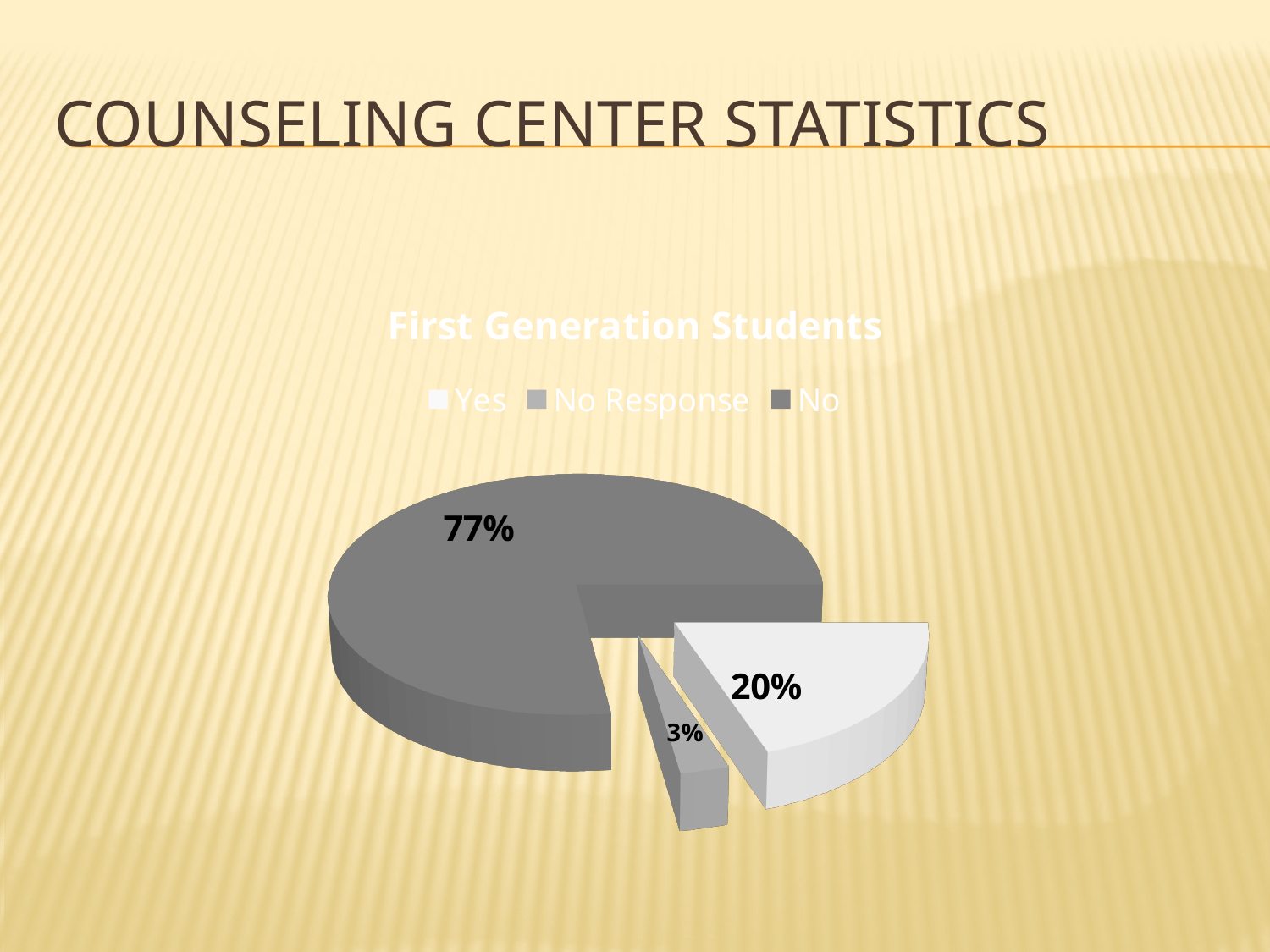
What are the three legend entries of the chart? Yes, No Response, No Which is larger, the "Yes" slice or the "No Response" slice? Yes How many slices does the pie chart have? 3 What is the difference in percentage points between the "No" slice and the "Yes" slice? 57 What is the title of the chart? First Generation Students What kind of chart is shown on the slide? Pie chart What is the difference in percentage points between the "Yes" slice and the "No Response" slice? 17 Which category has the smallest slice of the pie? No Response What share of the pie does the "Yes" slice represent? 20% Which category has the largest slice of the pie? No What share of the pie does the "No Response" slice represent? 3% What share of the pie does the "No" slice represent? 77%